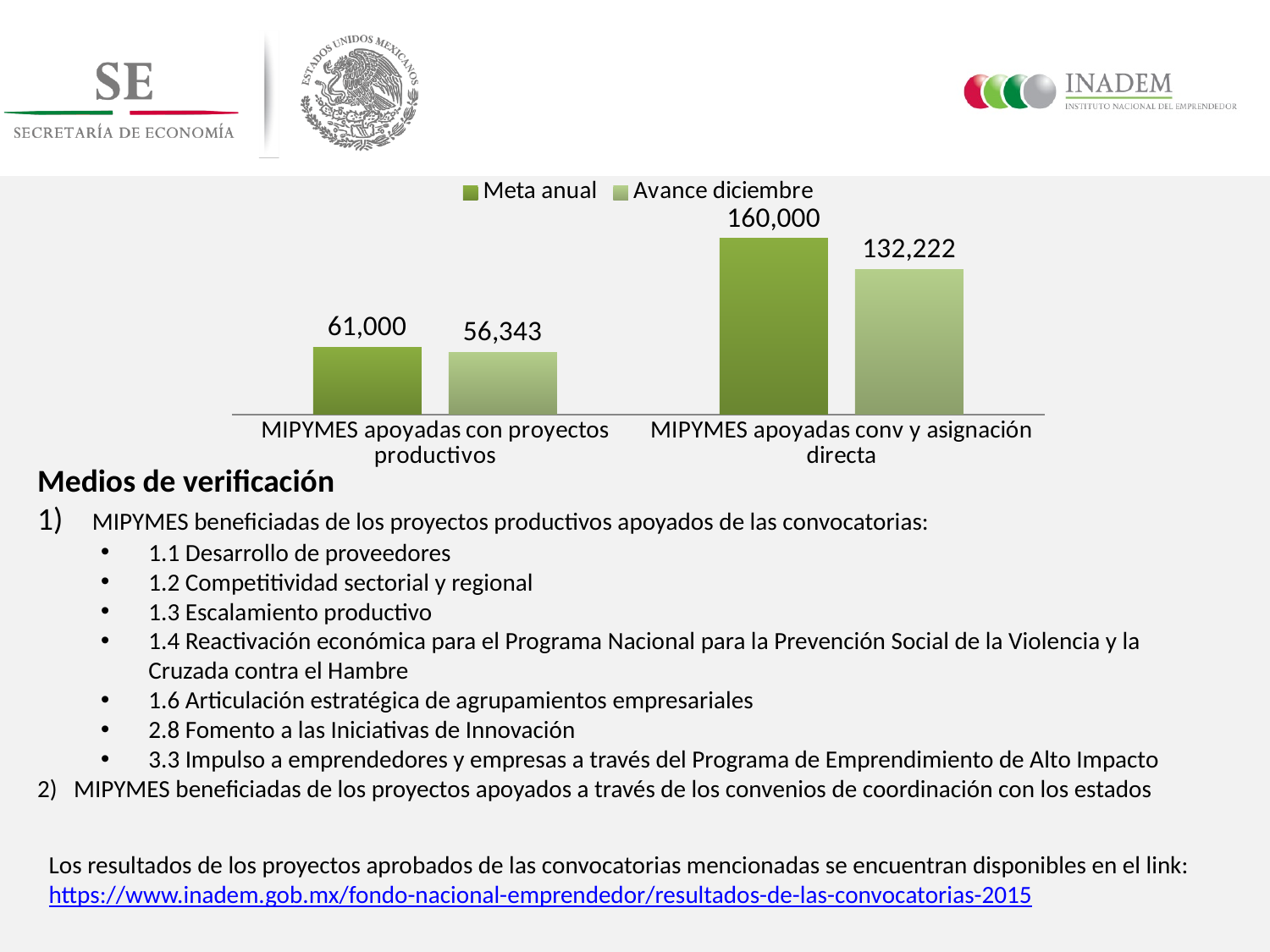
What is the difference between the Meta anual and Avance diciembre values for MIPYMES apoyadas conv y asignación directa? 27,778 How many series does the chart legend list? 2 What kind of chart is shown on the slide? Bar chart What is the Avance diciembre value for MIPYMES apoyadas con proyectos productivos? 56,343 What is the Avance diciembre value for MIPYMES apoyadas conv y asignación directa? 132,222 What is the Meta anual value for MIPYMES apoyadas con proyectos productivos? 61,000 How many categories are shown on the x axis of the chart? 2 Which category has the highest Meta anual value? MIPYMES apoyadas conv y asignación directa What is the Meta anual value for MIPYMES apoyadas conv y asignación directa? 160,000 Which is larger for MIPYMES apoyadas con proyectos productivos: Meta anual or Avance diciembre? Meta anual What is the difference between the Meta anual and Avance diciembre values for MIPYMES apoyadas con proyectos productivos? 4,657 Which category has the lowest Avance diciembre value? MIPYMES apoyadas con proyectos productivos